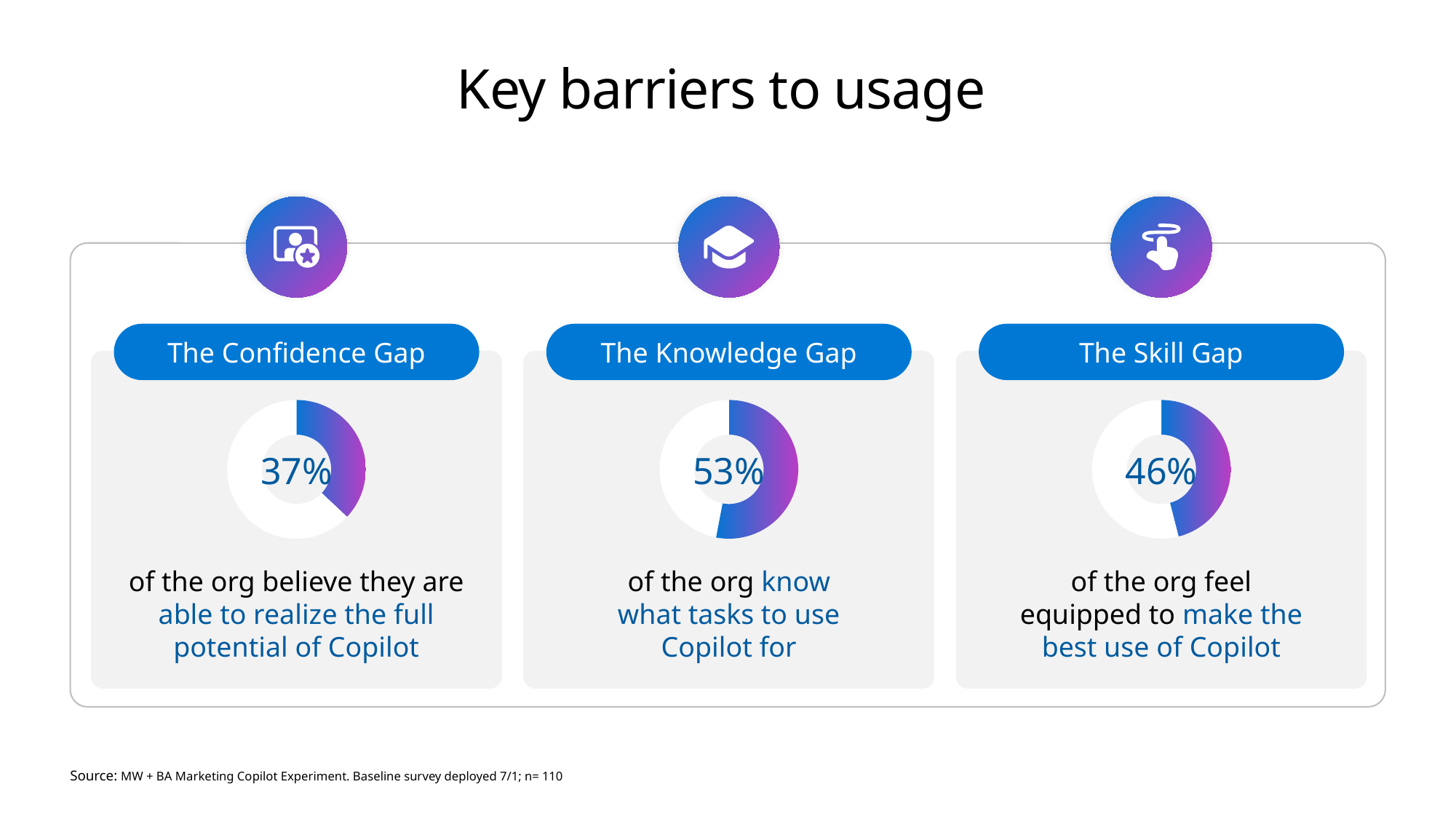
What is the title of the slide? Key barriers to usage Which of the three gap charts shows the lowest percentage? The Confidence Gap What is the difference between the Skill Gap percentage and the Confidence Gap percentage? 9% What kind of chart is used to show each percentage on the slide? Donut chart In the Skill Gap chart, what percentage of the org feel equipped to make the best use of Copilot? 46% In the Confidence Gap chart, what percentage of the org believe they are able to realize the full potential of Copilot? 37% Which is larger, the Skill Gap percentage or the Knowledge Gap percentage? The Knowledge Gap Is the Knowledge Gap percentage greater or less than 50%? greater How many gap charts are shown on the slide? 3 In the Knowledge Gap chart, what percentage of the org know what tasks to use Copilot for? 53% What is the difference between the Knowledge Gap percentage and the Confidence Gap percentage? 16% Which of the three gap charts shows the highest percentage? The Knowledge Gap